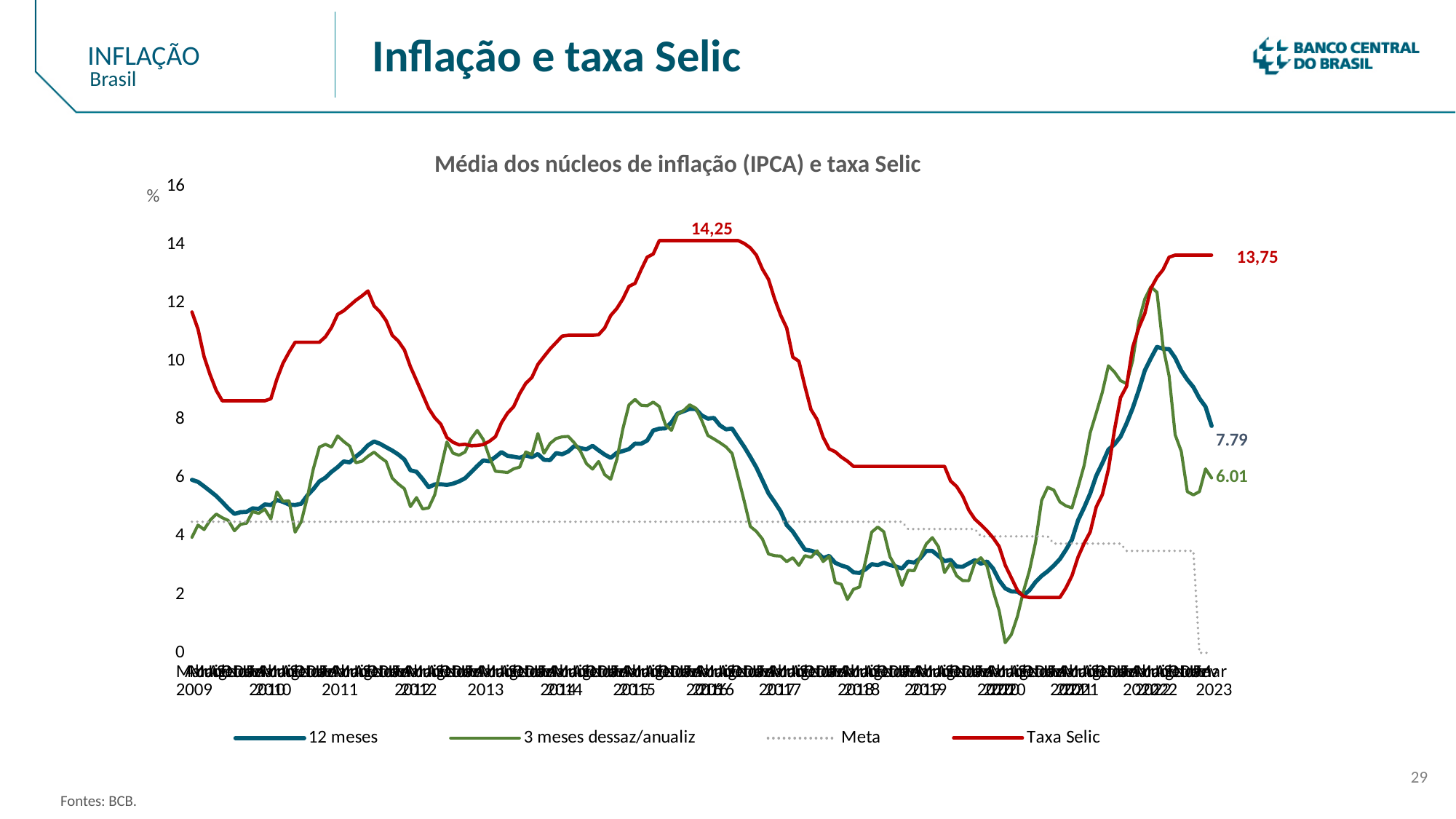
Is the Taxa Selic value at the start of 2009 greater or less than 10? greater What is the labelled peak value of the Taxa Selic series? 14,25 What is the difference between the labelled Taxa Selic peak (14,25) and its latest value (13,75)? 0,50 How many series does the legend list? 4 What is the title of the chart? Média dos núcleos de inflação (IPCA) e taxa Selic What is the latest labelled value of the 3 meses dessaz/anualiz series? 6.01 What kind of chart is shown on the slide? line chart Does the Taxa Selic series rise or fall between 2020 and 2023? rise What is the latest labelled value of the 12 meses series? 7.79 At the end of the chart, which is larger: the 12 meses value or the 3 meses dessaz/anualiz value? 12 meses What is the latest labelled value of the Taxa Selic series? 13,75 What is the difference between the latest labelled values of the 12 meses series (7.79) and the 3 meses dessaz/anualiz series (6.01)? 1.78